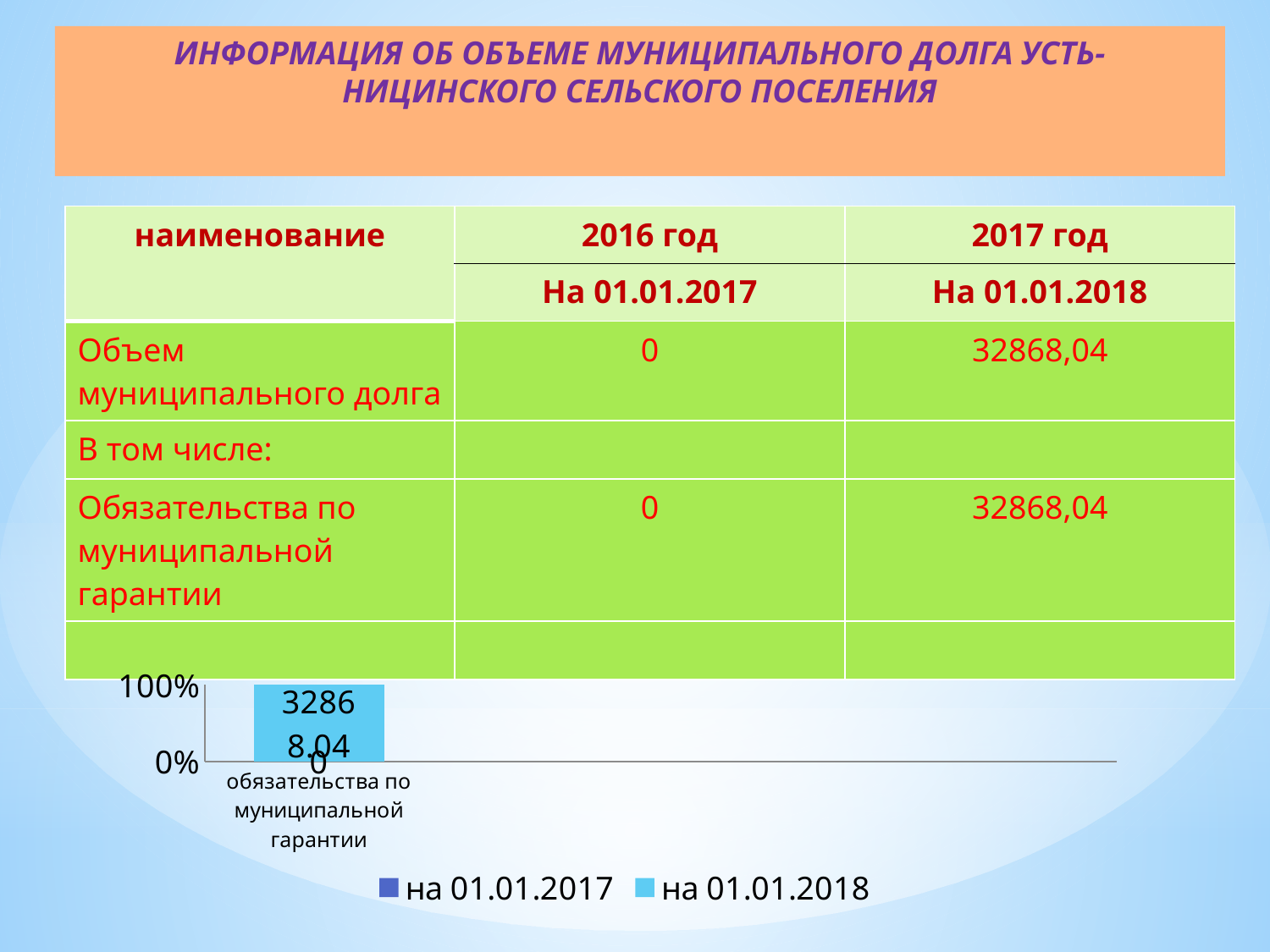
How many series does the chart legend list? 2 What is the category label on the x axis of the chart? обязательства по муниципальной гарантии What is the value for 'на 01.01.2018' for 'обязательства по муниципальной гарантии' in the chart? 32868,04 What is the highest tick label shown on the y axis of the chart? 100% What is the value for 'на 01.01.2017' for 'обязательства по муниципальной гарантии' in the chart? 0 What kind of chart is shown at the bottom of the slide? bar chart Which series has the larger value for 'обязательства по муниципальной гарантии' in the chart, 'на 01.01.2017' or 'на 01.01.2018'? на 01.01.2018 How many categories are plotted on the x axis of the chart? 1 What is the difference between the 'на 01.01.2018' and 'на 01.01.2017' values in the chart? 32868,04 What colour is the 'на 01.01.2018' series in the chart? light blue